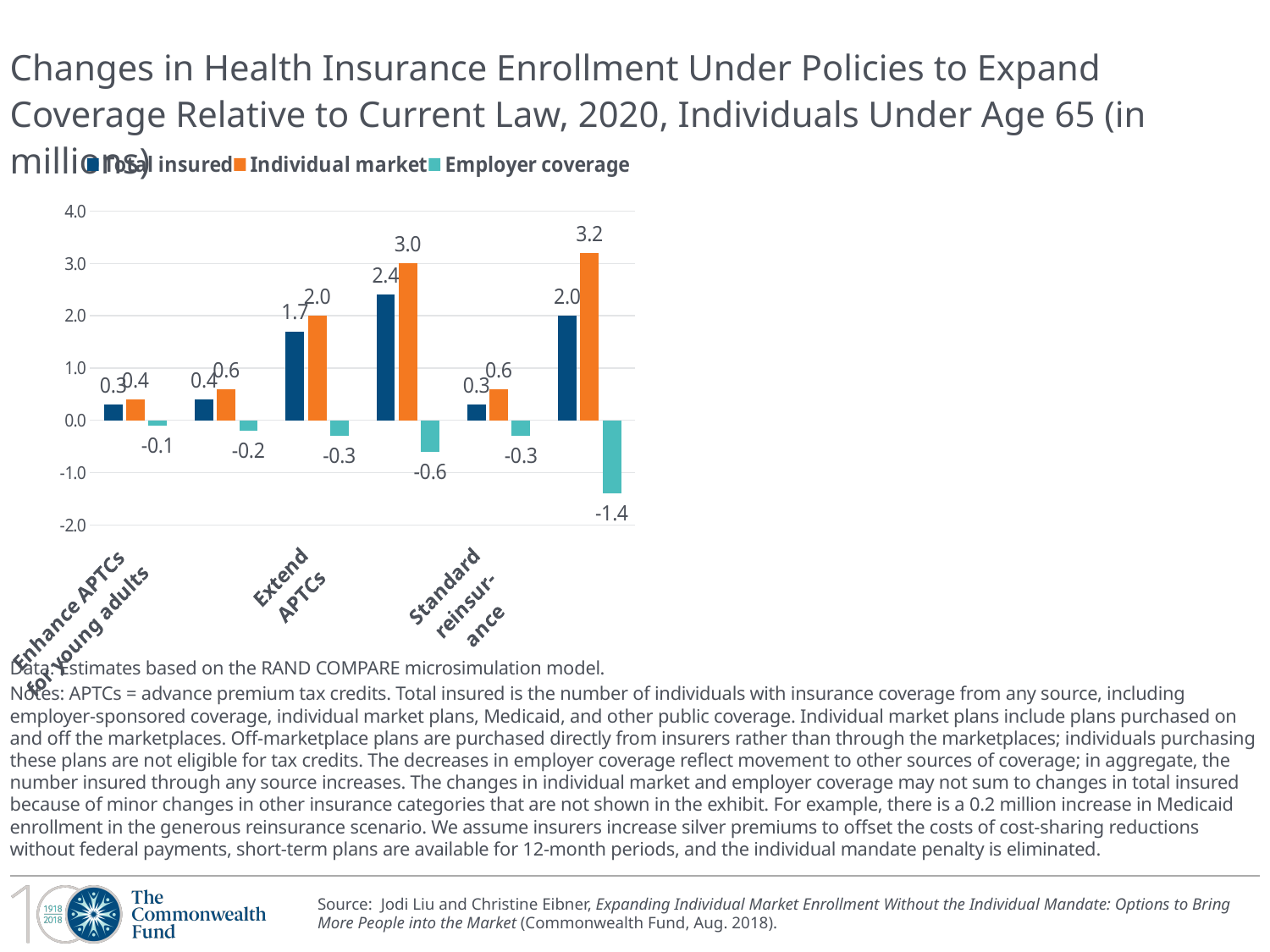
What is the difference between the Individual market and Total insured values for Extend APTCs? 0.3 What kind of chart is shown on the slide? bar chart What is the lowest Employer coverage value shown in the chart? -1.4 What is the Total insured value for Extend APTCs? 1.7 How many series does the legend list? 3 What is the Employer coverage value for Standard reinsurance? -0.3 What is the highest Individual market value shown in the chart? 3.2 What is the Employer coverage value for Enhance APTCs for young adults? -0.1 How many groups of bars (policy categories) are plotted in the chart? 6 What is the Individual market value for Extend APTCs? 2.0 Which has the larger Total insured value, Extend APTCs or Standard reinsurance? Extend APTCs What is the Individual market value for Enhance APTCs for young adults? 0.4